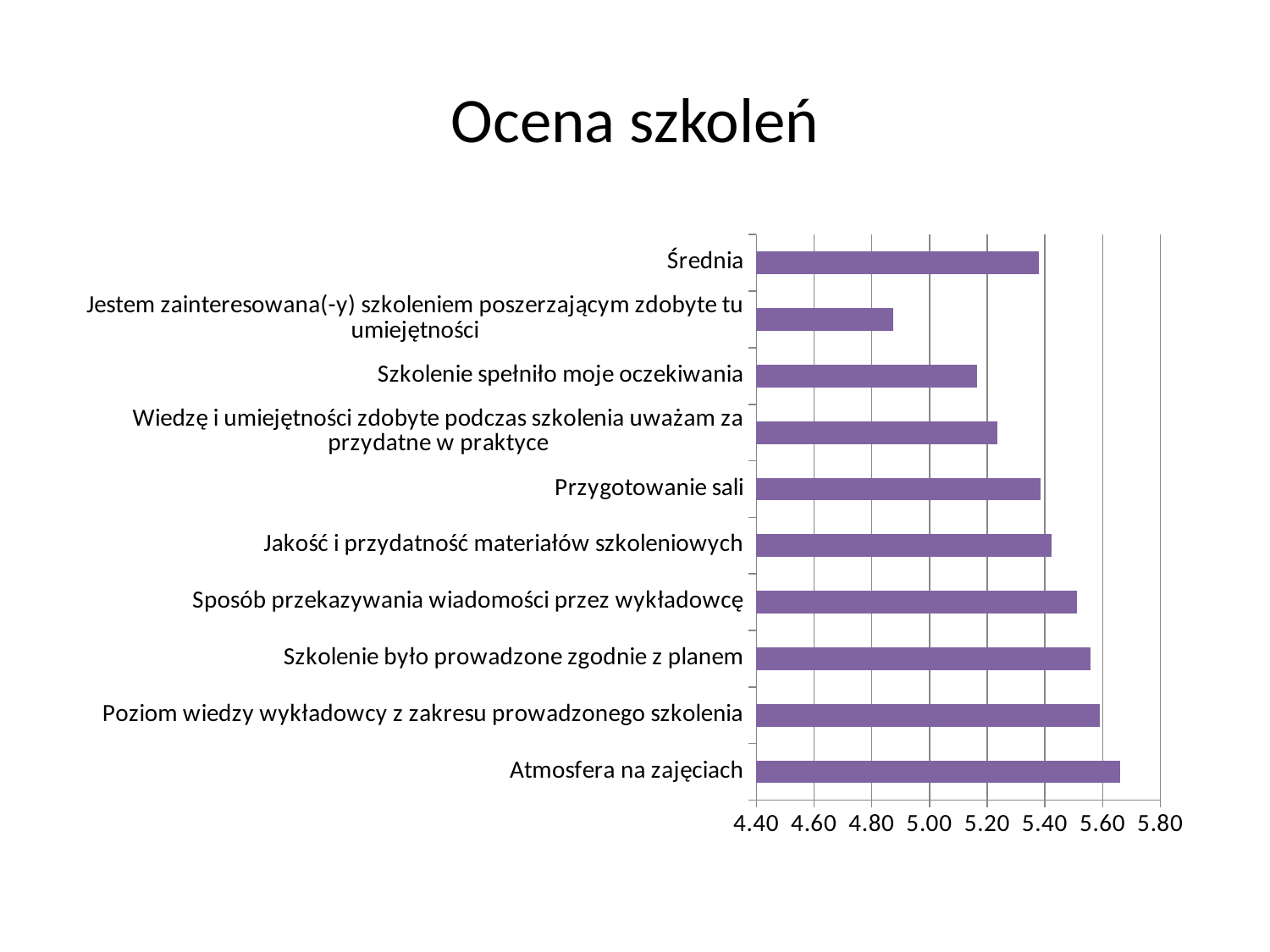
Is the value for Atmosfera na zajęciach greater or less than 5.60? greater What kind of chart is shown on the slide? bar chart Which is larger: the value for Sposób przekazywania wiadomości przez wykładowcę or the value for Szkolenie spełniło moje oczekiwania? Sposób przekazywania wiadomości przez wykładowcę Is the value for Poziom wiedzy wykładowcy z zakresu prowadzonego szkolenia greater or less than 5.40? greater How many categories are plotted in the chart? 10 What is the lowest value shown on the horizontal axis? 4.40 Is the value for Szkolenie spełniło moje oczekiwania greater or less than 5.20? less Which category has the highest value? Atmosfera na zajęciach What is the title of the chart? Ocena szkoleń Which is larger: the value for Przygotowanie sali or the value for Poziom wiedzy wykładowcy z zakresu prowadzonego szkolenia? Poziom wiedzy wykładowcy z zakresu prowadzonego szkolenia Which category has the lowest value? Jestem zainteresowana(-y) szkoleniem poszerzającym zdobyte tu umiejętności